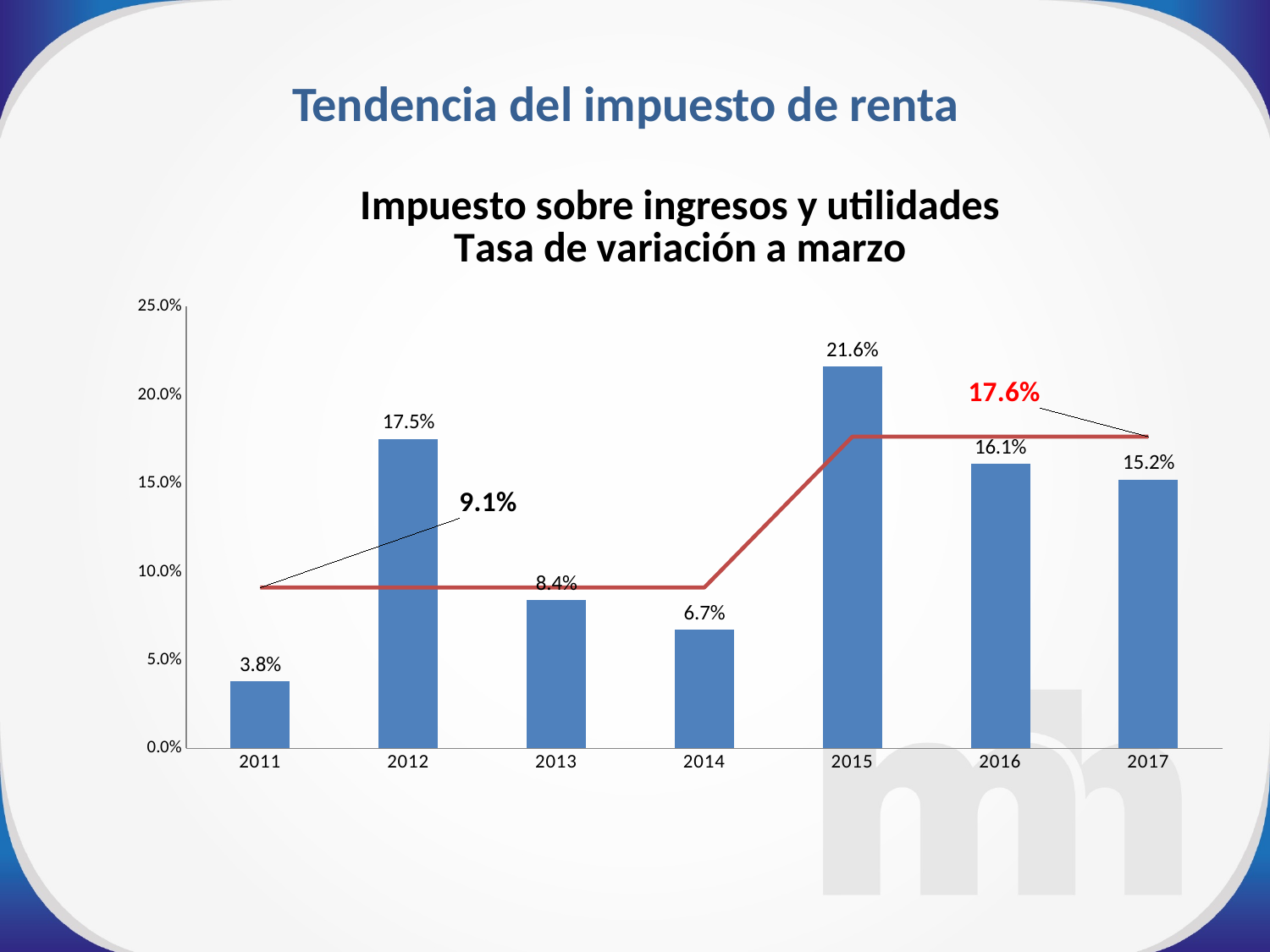
What is the value for 2017? 15.2% What is the value for 2015? 21.6% What is the value for 2011? 3.8% How many years are shown on the x axis? 7 Which year has the lowest value? 2011 What is the difference between the values for 2015 and 2016? 5.5% Which year has the highest value? 2015 What kind of chart is this? combination bar and line chart Do the values rise or fall from 2015 to 2017? fall Is the value for 2014 greater or less than 10.0%? less Which is larger, the value for 2012 or the value for 2016? 2012 What value does the red line show for the period 2015 to 2017? 17.6%